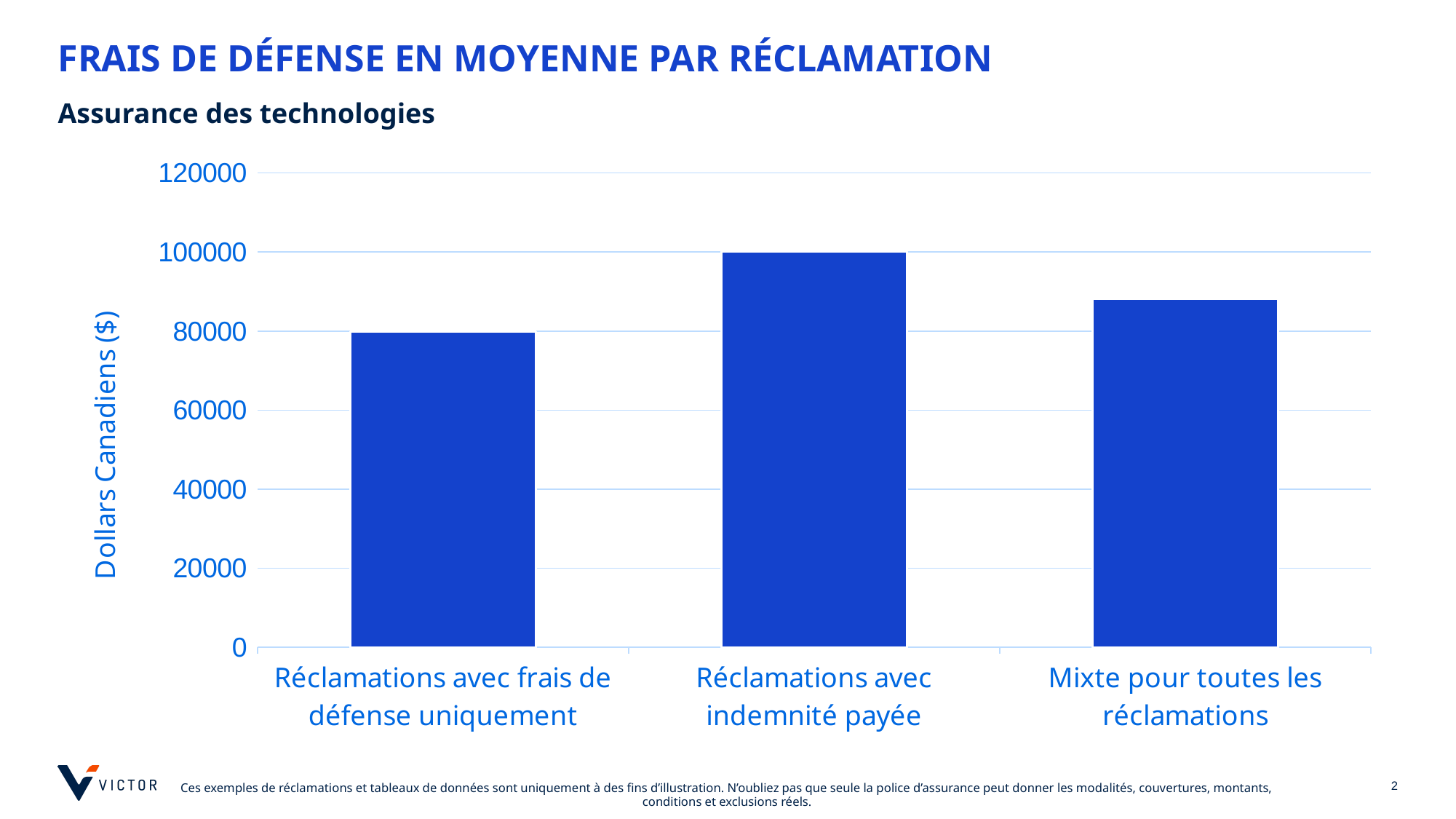
Is the value for 'Mixte pour toutes les réclamations' greater or less than 100000? less What is the title of the slide containing the chart? FRAIS DE DÉFENSE EN MOYENNE PAR RÉCLAMATION Is the value for 'Mixte pour toutes les réclamations' greater or less than 80000? greater Which is larger: the value for 'Réclamations avec indemnité payée' or the value for 'Mixte pour toutes les réclamations'? Réclamations avec indemnité payée What is the label of the vertical axis? Dollars Canadiens ($) Which category has the lowest average defence cost? Réclamations avec frais de défense uniquement How many categories are plotted on the chart? 3 Which category has the highest average defence cost? Réclamations avec indemnité payée What kind of chart is shown on the slide? bar chart